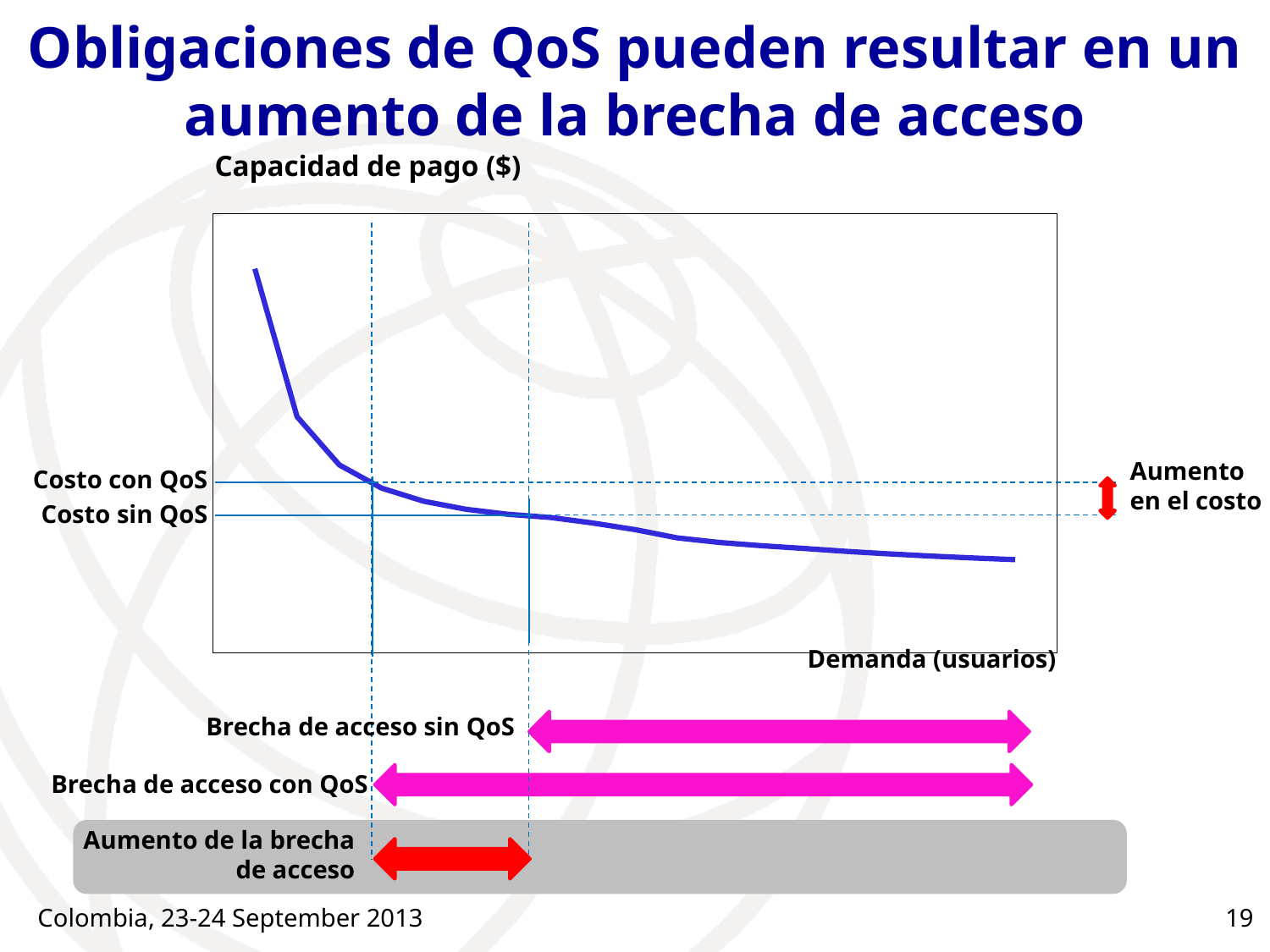
How many lines (series) are plotted in the chart? 1 What kind of chart is shown on the slide? line chart Which access gap is wider, 'Brecha de acceso sin QoS' or 'Brecha de acceso con QoS'? Brecha de acceso con QoS Which cost level is higher on the chart, 'Costo con QoS' or 'Costo sin QoS'? Costo con QoS What is the label of the vertical (y) axis of the chart? Capacidad de pago ($) What is the label of the horizontal (x) axis of the chart? Demanda (usuarios) Does the plotted line rise or fall as demand (Demanda) increases along the x axis? fall